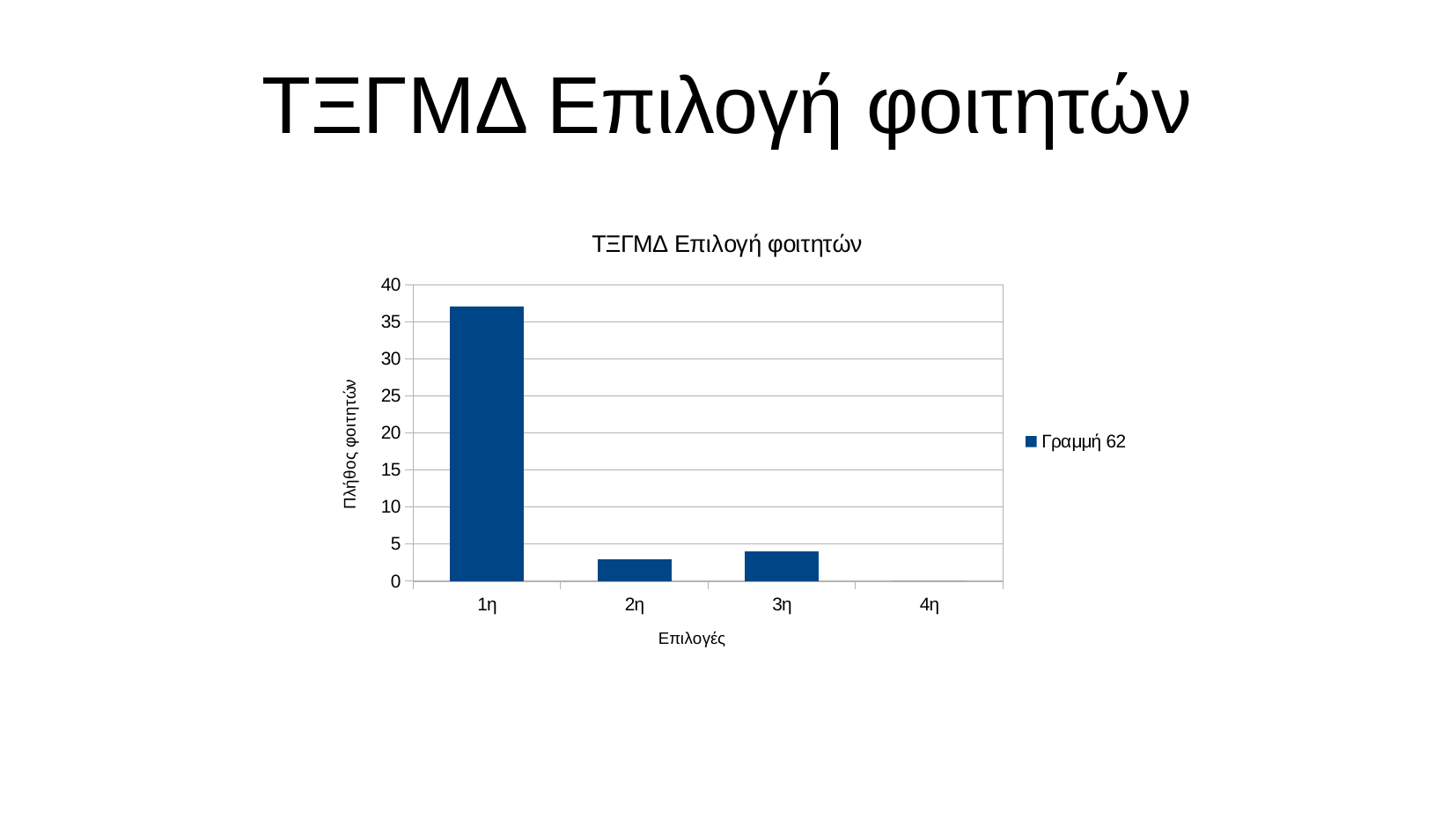
What series name is shown in the chart's legend? Γραμμή 62 Is the value for 1η greater or less than 35? greater Which is larger, the value for 1η or the value for 2η? 1η Which is larger, the value for 1η or the value for 3η? 1η What is the title of the chart? ΤΞΓΜΔ Επιλογή φοιτητών How many categories are shown on the x axis of the chart? 4 Is the value for 2η greater or less than 5? less Which category has the lowest value in the chart? 4η What kind of chart is shown on the slide? bar chart Is the value for 1η greater or less than 40? less How many series does the chart's legend list? 1 Which category has the highest value in the chart? 1η